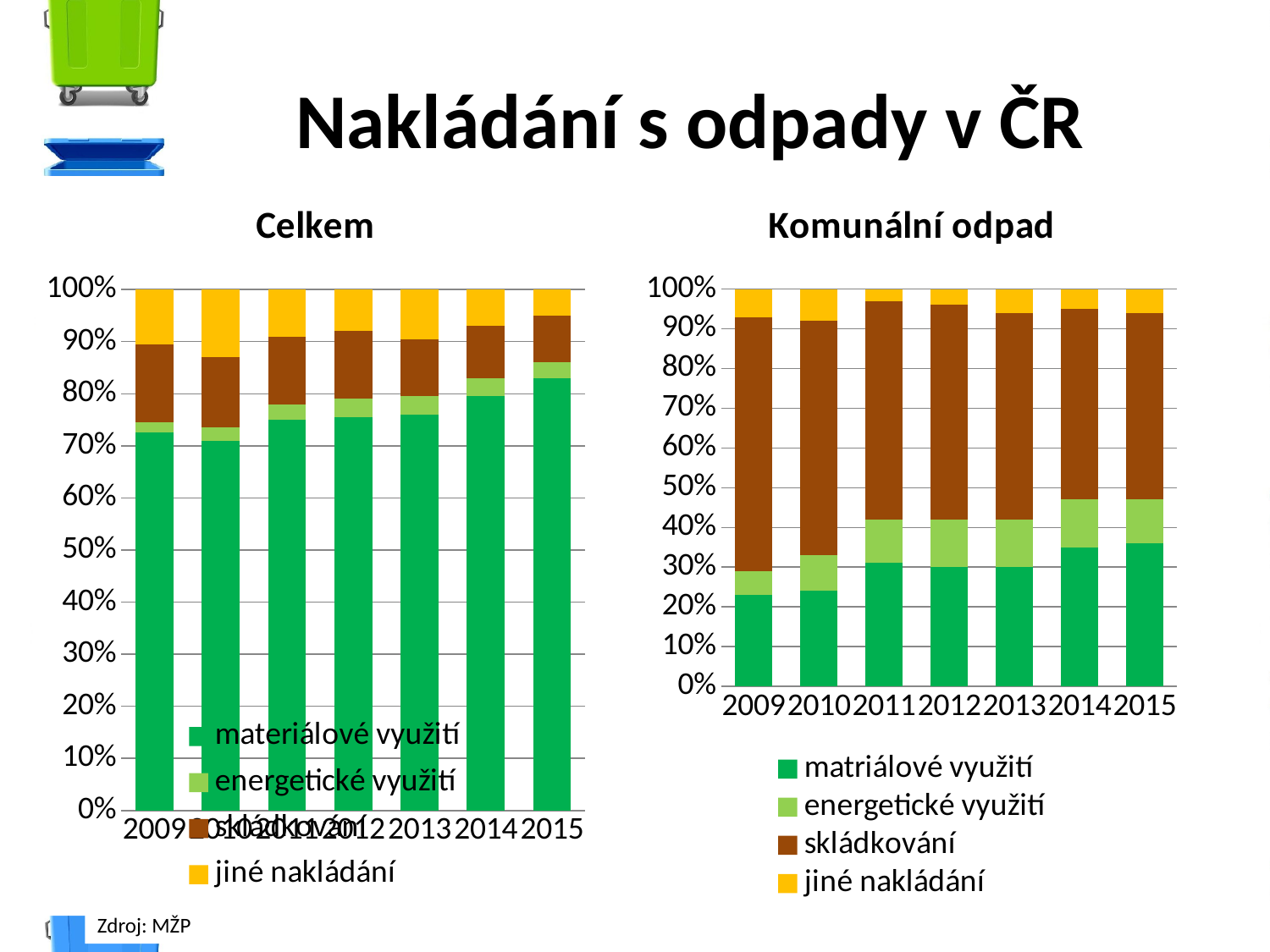
What is the title of the chart on the right? Komunální odpad In the 'Celkem' chart, is the value for materiálové využití in 2009 greater or less than 80%? less How many years are shown on the x axis of the 'Komunální odpad' chart? 7 What kind of chart is the 'Celkem' chart on the left? stacked bar chart How many series does the legend of the 'Celkem' chart list? 4 In the 'Celkem' chart, what is the total of the stacked bar for 2015? 100% In the 'Komunální odpad' chart, is the value for matriálové využití in 2015 greater or less than 30%? greater In the 'Komunální odpad' chart, does the share of matriálové využití rise or fall from 2009 to 2015? rise Which series is shown in yellow in the 'Komunální odpad' chart? jiné nakládání In the 'Komunální odpad' chart, which year has the largest matriálové využití share, 2009 or 2015? 2015 In the 'Komunální odpad' chart, is the value for matriálové využití in 2009 greater or less than 30%? less